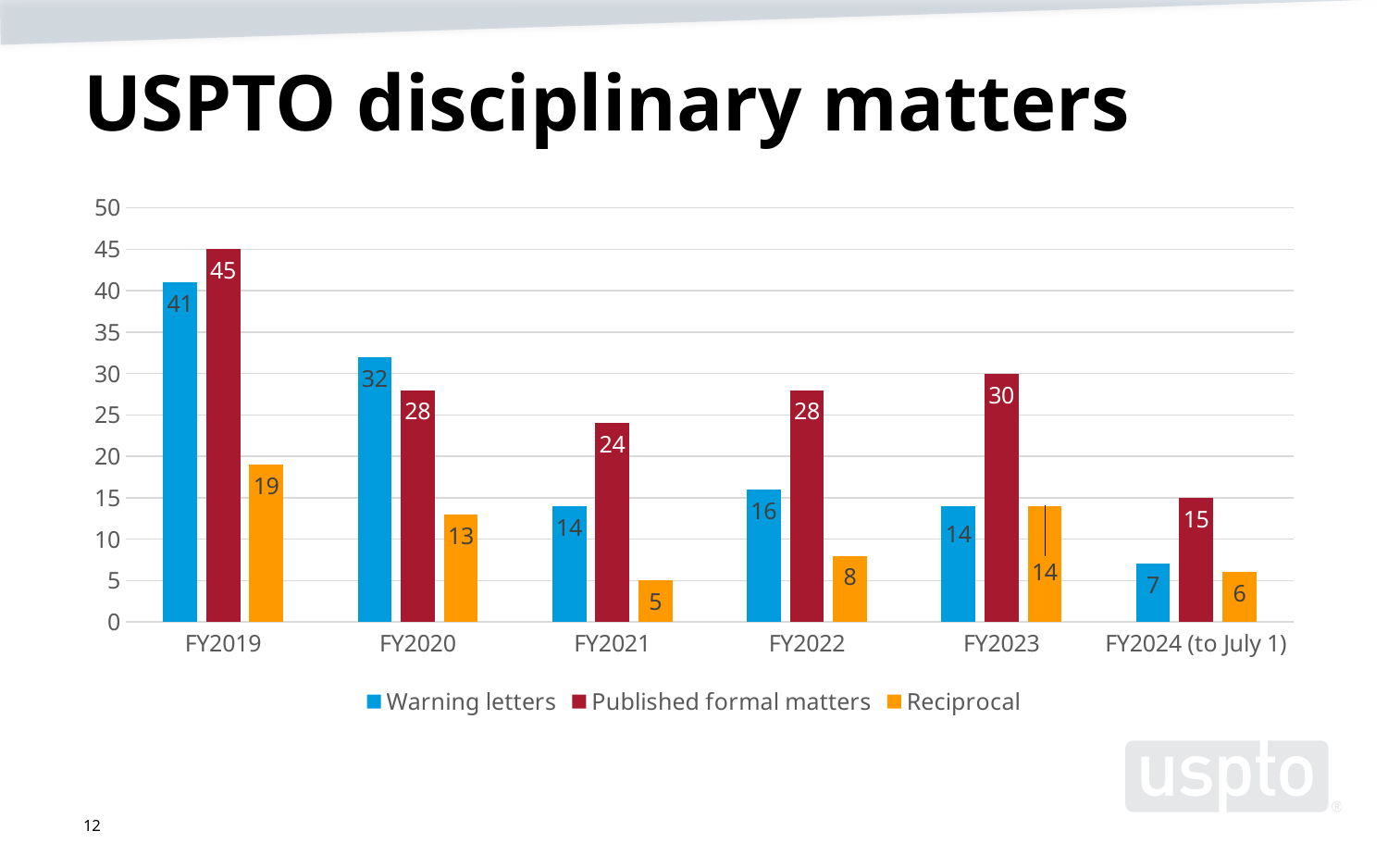
Which fiscal year has the lowest value for Warning letters? FY2024 (to July 1) What is the value for Warning letters in FY2019? 41 How many series does the legend list? 3 In FY2022, which is larger: Warning letters or Published formal matters? Published formal matters Do the Warning letters values rise or fall from FY2019 to FY2021? Fall What is the difference between Published formal matters and Warning letters in FY2021? 10 What is the value for Published formal matters in FY2023? 30 How many fiscal year categories are shown on the x axis? 6 What kind of chart is shown on the slide? Bar chart What is the value for Reciprocal in FY2021? 5 Which fiscal year has the highest value for Published formal matters? FY2019 Is the value for Warning letters in FY2020 greater or less than 30? greater